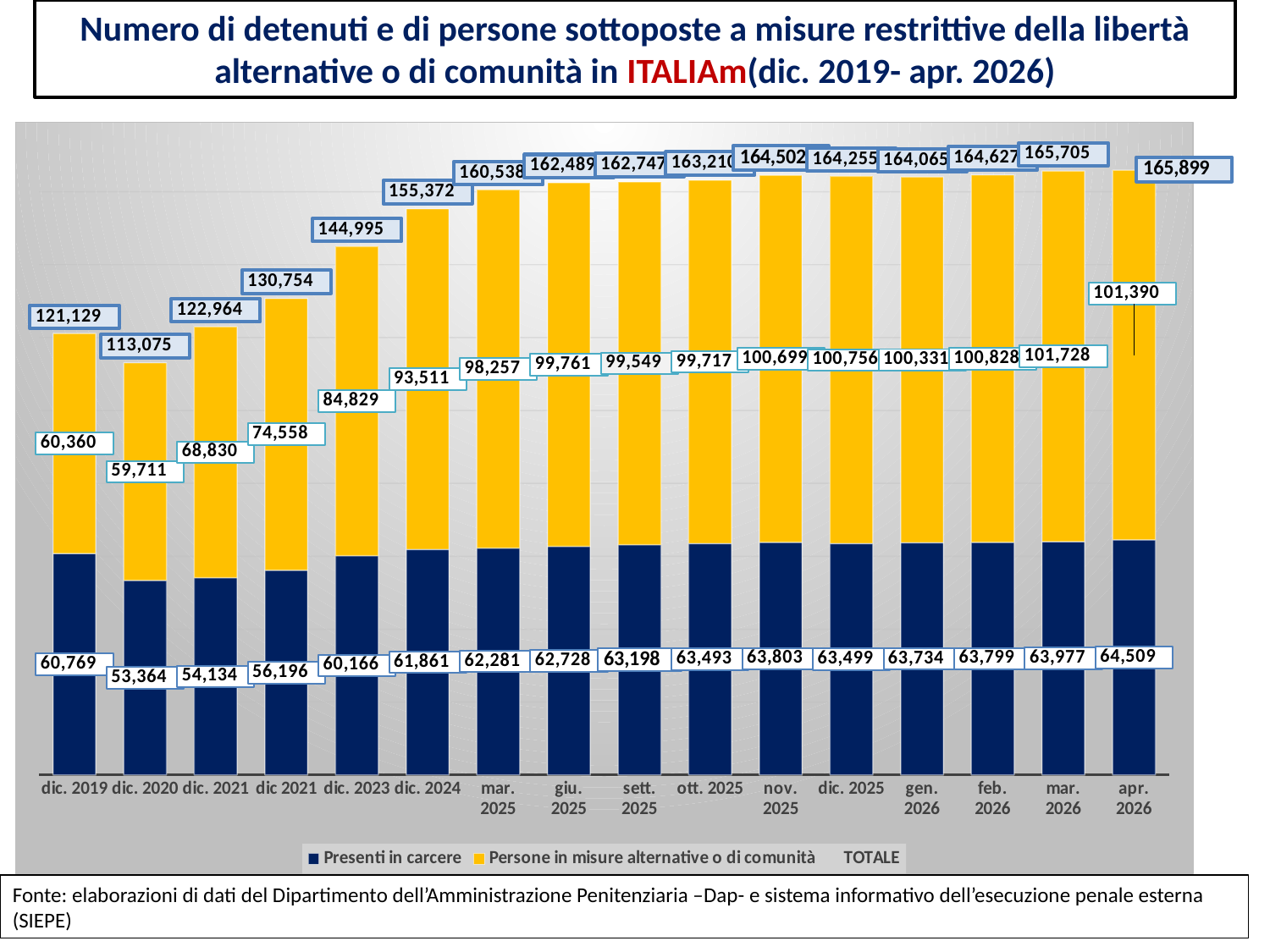
What is the TOTALE value shown for apr. 2026? 165,899 What is the value for "Persone in misure alternative o di comunità" in dic. 2023? 84,829 What is the difference between the "Presenti in carcere" value in apr. 2026 and in dic. 2019? 3,740 What is the value for "Persone in misure alternative o di comunità" in apr. 2026? 101,390 What is the difference between the TOTALE values for apr. 2026 and mar. 2026? 194 How many periods are shown on the x axis? 16 What is the value for "Presenti in carcere" in dic. 2019? 60,769 Which period has the lowest TOTALE value? dic. 2020 What kind of chart is shown on the slide? Stacked bar chart In dic. 2019, which is larger: "Presenti in carcere" or "Persone in misure alternative o di comunità"? Presenti in carcere How many entries does the legend list? 3 Which period has the highest value for "Presenti in carcere"? apr. 2026